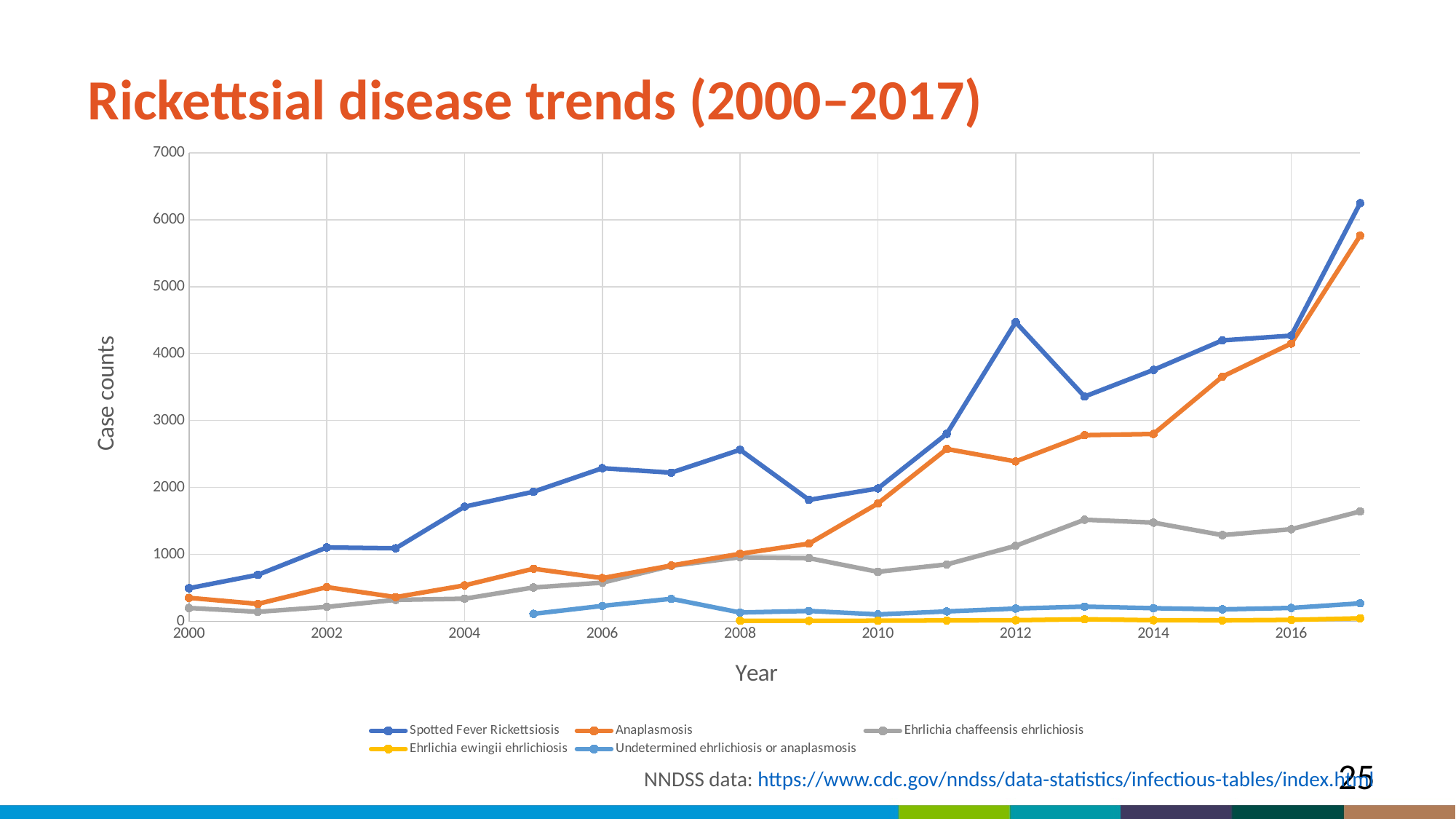
How many years are plotted along the x axis for Spotted Fever Rickettsiosis? 18 Which series has the highest case count in 2017? Spotted Fever Rickettsiosis What kind of chart is shown on the slide? line chart Is the value for Anaplasmosis in 2017 greater or less than 5000? greater In 2012, which is larger: Spotted Fever Rickettsiosis or Anaplasmosis? Spotted Fever Rickettsiosis Is the value for Ehrlichia chaffeensis ehrlichiosis in 2017 greater or less than 1000? greater Do Anaplasmosis case counts rise or fall overall from 2000 to 2017? rise Is the value for Spotted Fever Rickettsiosis in 2017 greater or less than 6000? greater What is the label on the y axis? Case counts Which series has the lowest case count in 2017? Ehrlichia ewingii ehrlichiosis In which year does Spotted Fever Rickettsiosis reach its highest case count? 2017 How many series does the legend list? 5